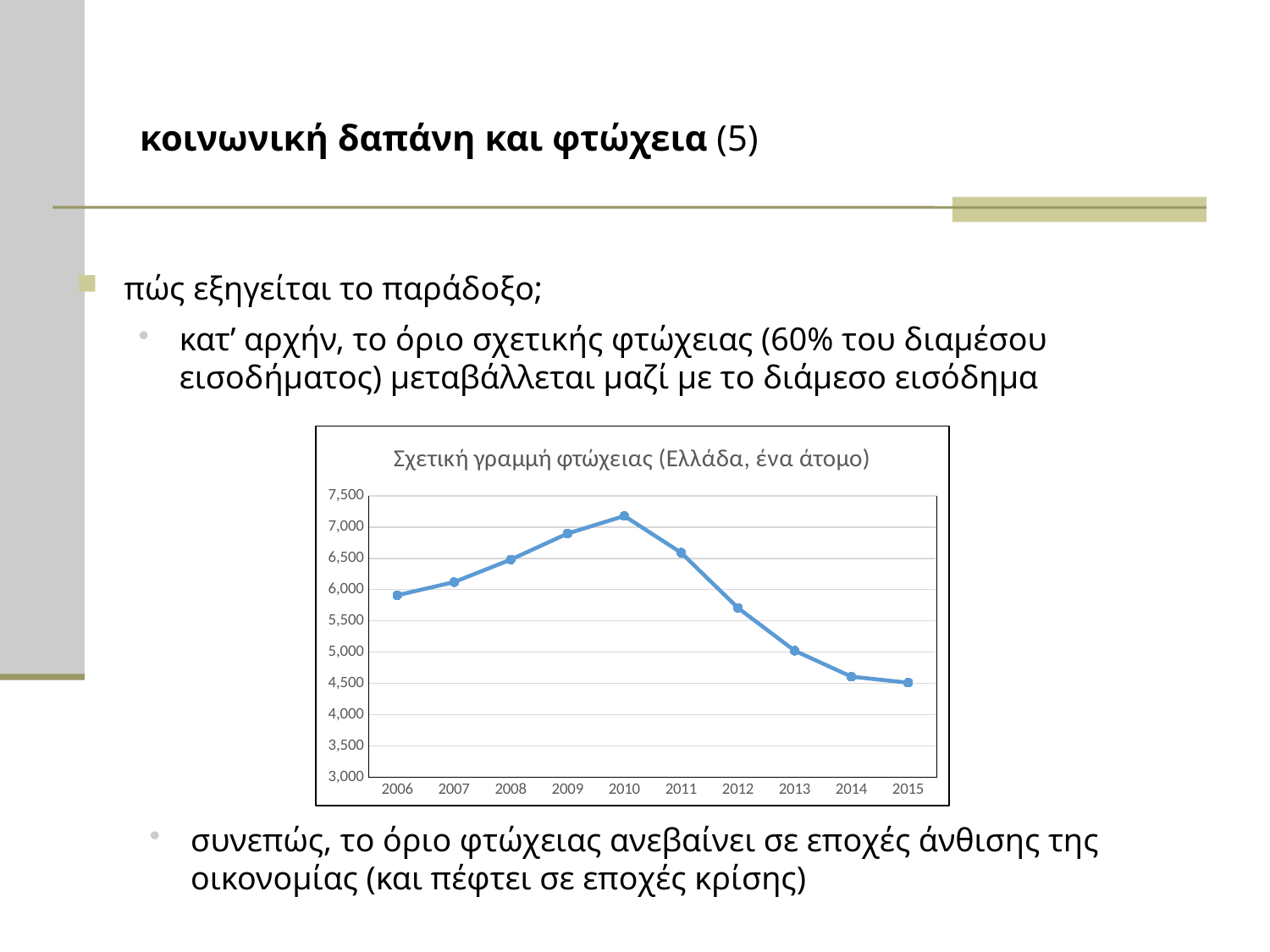
How many years are plotted on the x axis of the chart? 10 In which year does the relative poverty line reach its highest value? 2010 Which year has the higher value, 2009 or 2012? 2009 In which year does the relative poverty line reach its lowest value? 2015 What is the title of the chart? Σχετική γραμμή φτώχειας (Ελλάδα, ένα άτομο) What kind of chart is shown on the slide? line chart Do the values rise or fall from 2006 to 2010? rise Is the value for 2009 greater or less than 6,500? greater Is the value for 2010 greater or less than 7,000? greater Is the value for 2015 greater or less than 5,000? less Do the values rise or fall from 2010 to 2015? fall